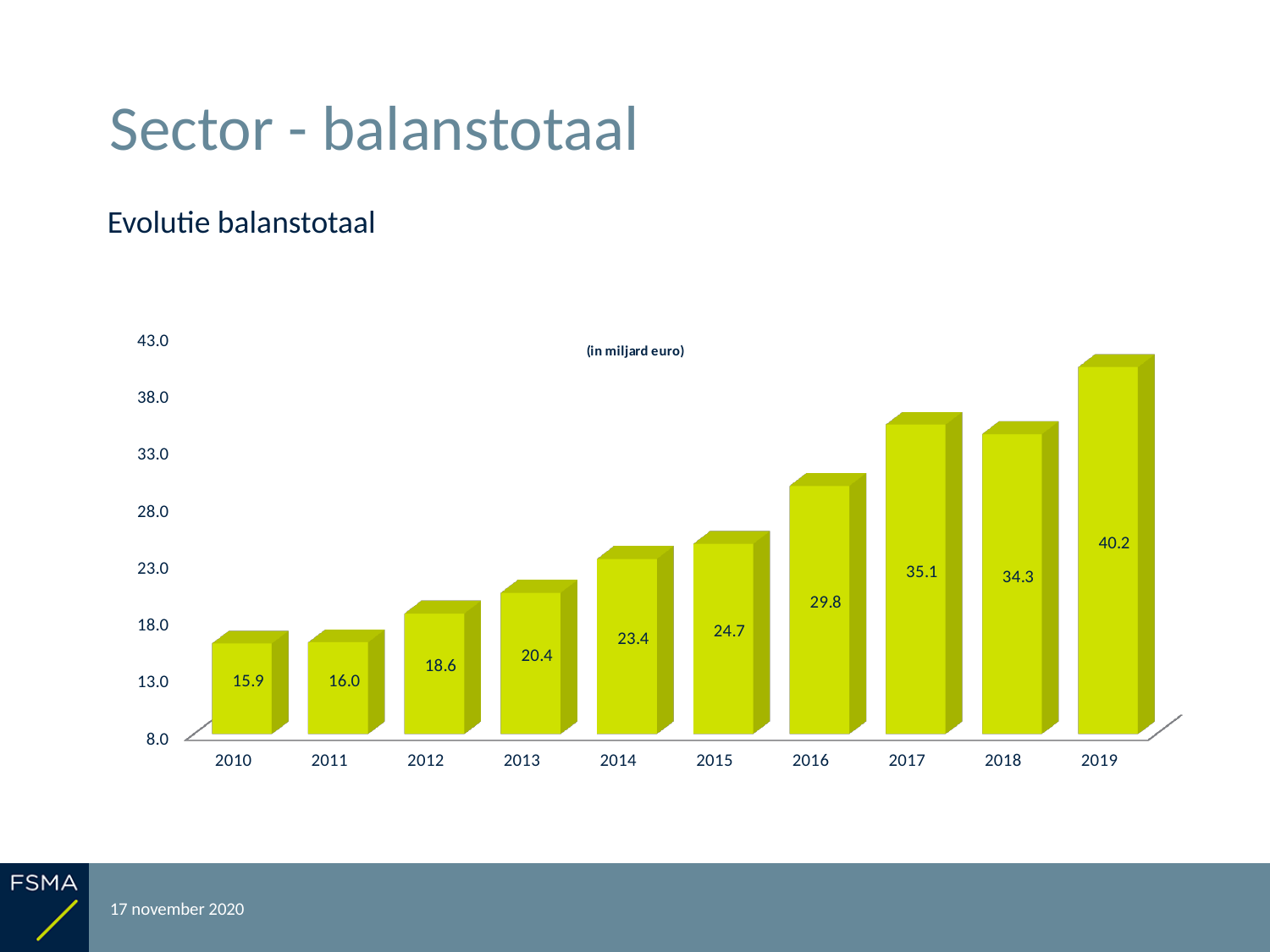
What is the value for 2016? 29.8 Is the value for 2015 greater or less than 23.0? greater What is the difference between the values for 2019 and 2010? 24.3 What unit is stated in the label at the top of the chart? in miljard euro What kind of chart is shown on the slide? bar chart What is the difference between the values for 2017 and 2018? 0.8 How many years are shown on the x axis? 10 What is the value for 2010? 15.9 What is the value for 2019? 40.2 Which is larger, the value for 2017 or the value for 2018? 2017 Which year has the highest value? 2019 Which year has the lowest value? 2010